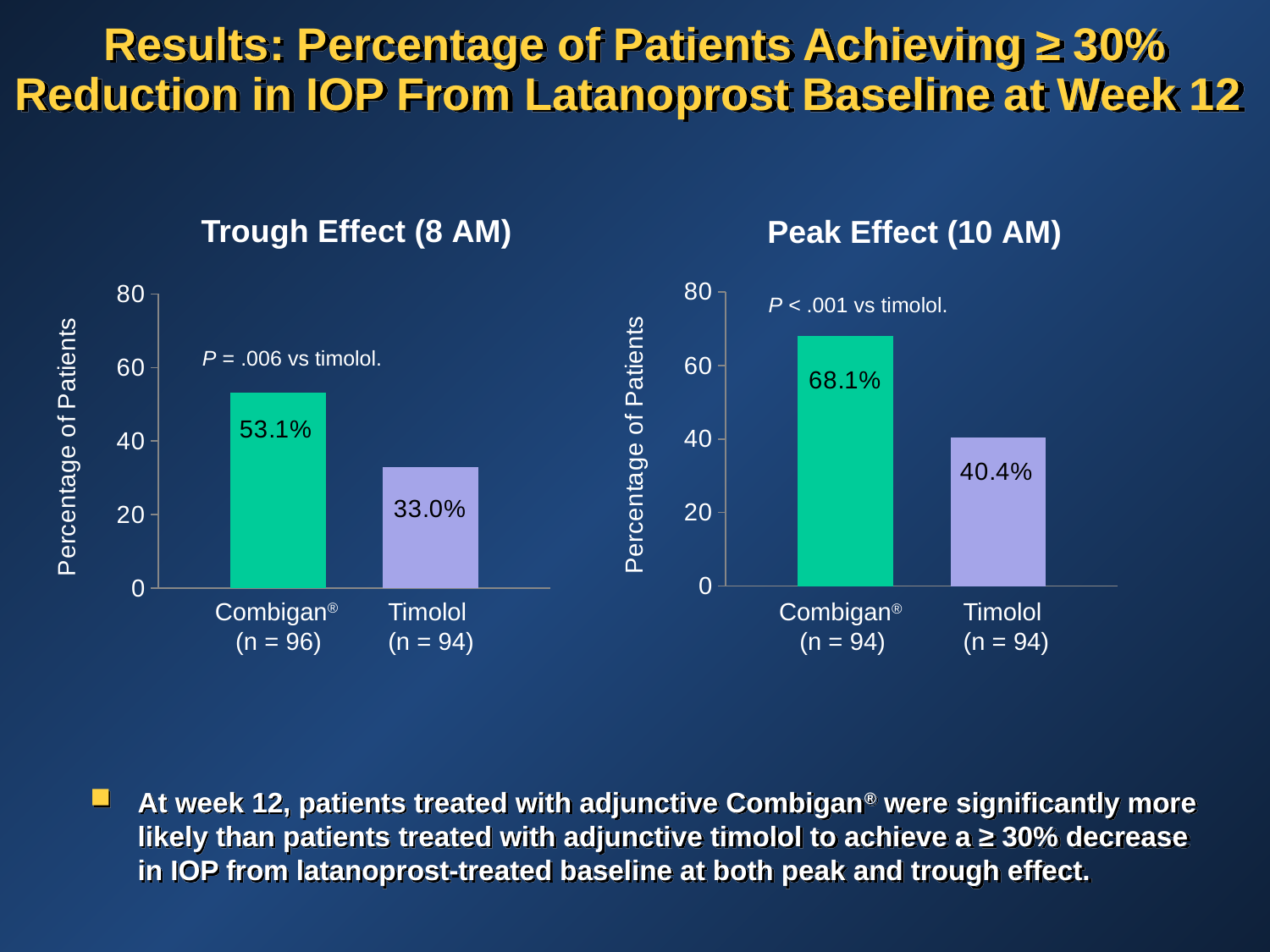
Is the Combigan value in the Peak Effect (10 AM) chart larger or smaller than the Combigan value in the Trough Effect (8 AM) chart? larger In the Trough Effect (8 AM) chart, what percentage of patients is shown for Timolol? 33.0% In the Peak Effect (10 AM) chart, what percentage of patients is shown for Combigan? 68.1% How many bars are shown in the Peak Effect (10 AM) chart? 2 In the Trough Effect (8 AM) chart, which treatment has the higher percentage of patients? Combigan In the Peak Effect (10 AM) chart, which treatment has the lower percentage of patients? Timolol In the Trough Effect (8 AM) chart, what percentage of patients is shown for Combigan? 53.1% In the Trough Effect (8 AM) chart, what is the difference in percentage points between Combigan and Timolol? 20.1 In the Peak Effect (10 AM) chart, what percentage of patients is shown for Timolol? 40.4% In the Peak Effect (10 AM) chart, what is the difference in percentage points between Combigan and Timolol? 27.7 What type of chart is the Trough Effect (8 AM) chart? Bar chart In the Trough Effect (8 AM) chart, is the value for Timolol greater or less than 40? less